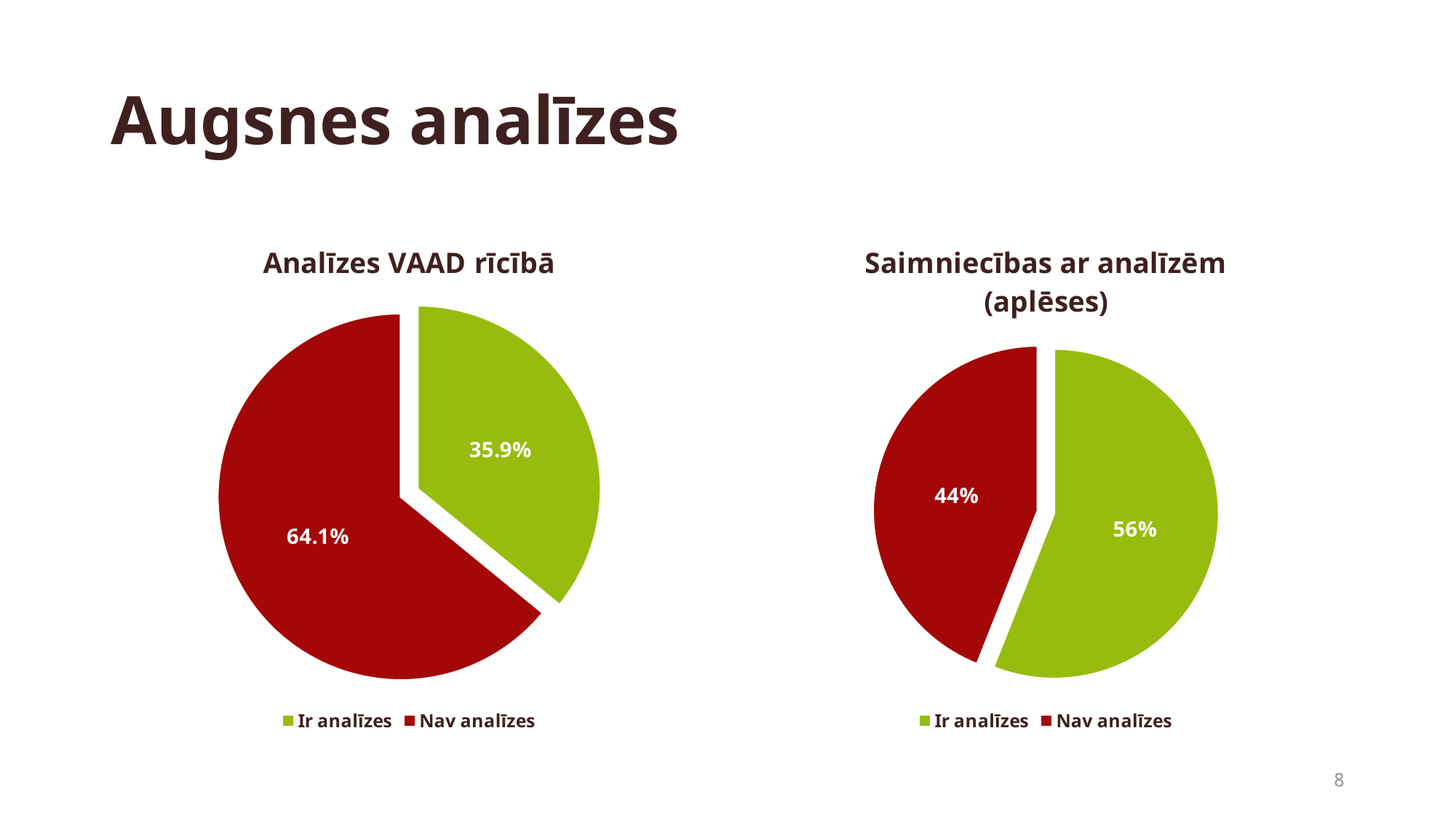
In the chart titled "Analīzes VAAD rīcībā", what share does "Nav analīzes" have? 64.1% In the chart titled "Analīzes VAAD rīcībā", what share does "Ir analīzes" have? 35.9% In the chart titled "Saimniecības ar analīzēm (aplēses)", which slice is the smallest? Nav analīzes In the chart titled "Analīzes VAAD rīcībā", which slice is the largest? Nav analīzes In the chart titled "Analīzes VAAD rīcībā", what is the difference between the "Nav analīzes" and "Ir analīzes" shares? 28.2% What type of chart is the chart on the left of the slide? Pie chart In the chart titled "Saimniecības ar analīzēm (aplēses)", what is the difference between the "Ir analīzes" and "Nav analīzes" shares? 12% In the chart titled "Saimniecības ar analīzēm (aplēses)", what share does "Ir analīzes" have? 56% In the chart titled "Saimniecības ar analīzēm (aplēses)", what colour is the "Ir analīzes" slice? Green In the chart titled "Saimniecības ar analīzēm (aplēses)", which is larger: "Ir analīzes" or "Nav analīzes"? Ir analīzes In the chart titled "Saimniecības ar analīzēm (aplēses)", what share does "Nav analīzes" have? 44% How many slices does the chart titled "Analīzes VAAD rīcībā" have? 2